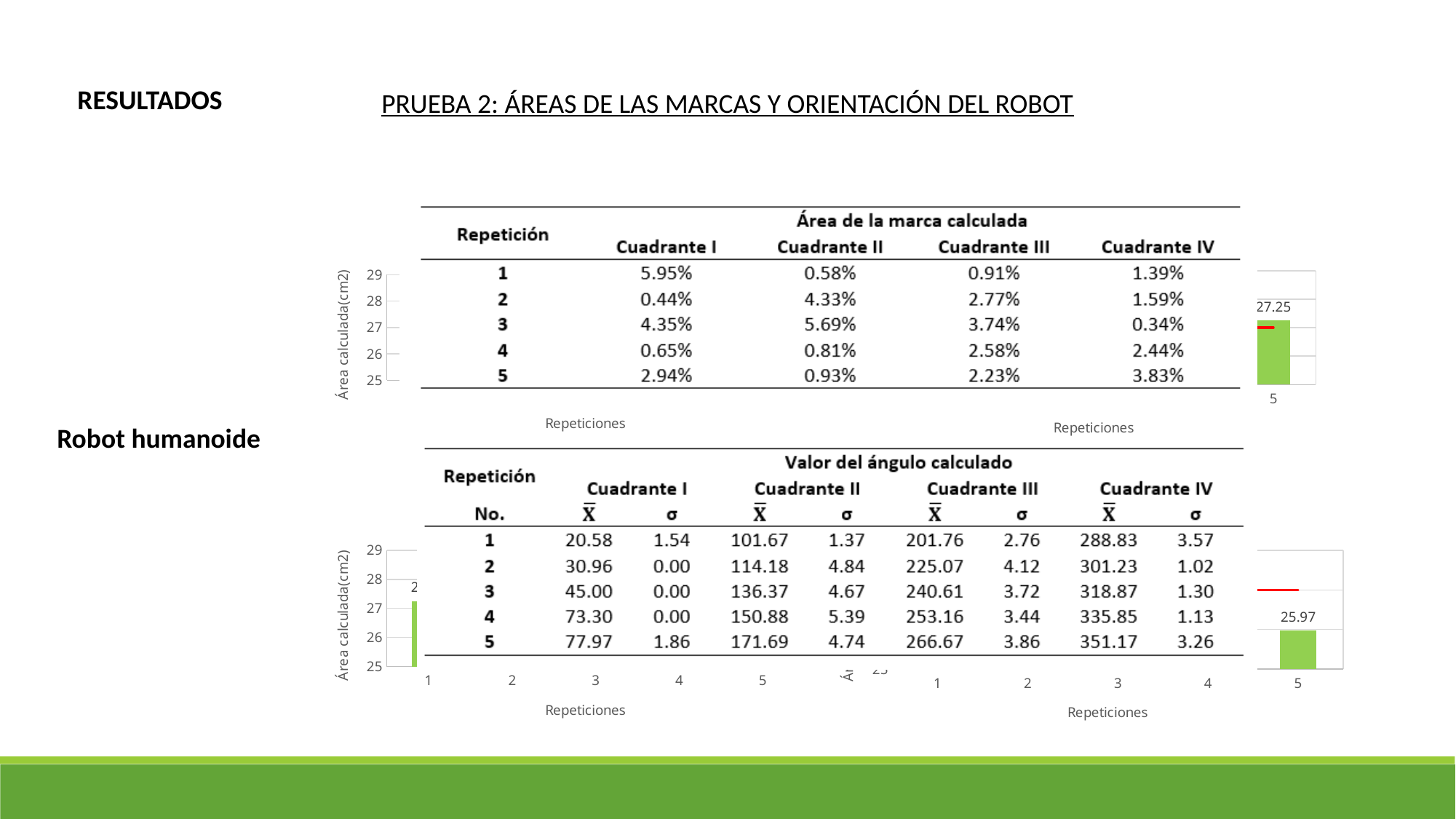
What is the x-axis title of the bottom-left chart? Repeticiones In the top-right chart, what is the value labelled on the bar for repetition 5? 27.25 What is the y-axis title of the bottom-left chart? Área calculada(cm2) How many repetitions are shown on the x axis of the bottom-right chart? 5 In the bottom-right chart, is the value for repetition 5 greater or less than 26? less Which is larger: the repetition 5 value in the top-right chart or the repetition 5 value in the bottom-right chart? the top-right chart (27.25) In the bottom-right chart, what is the value labelled on the bar for repetition 5? 25.97 What is the difference between the repetition 5 value in the top-right chart (27.25) and the repetition 5 value in the bottom-right chart (25.97)? 1.28 What kind of chart is the bottom-right chart? bar chart In the bottom-left chart, is the value for repetition 1 greater or less than 27? greater